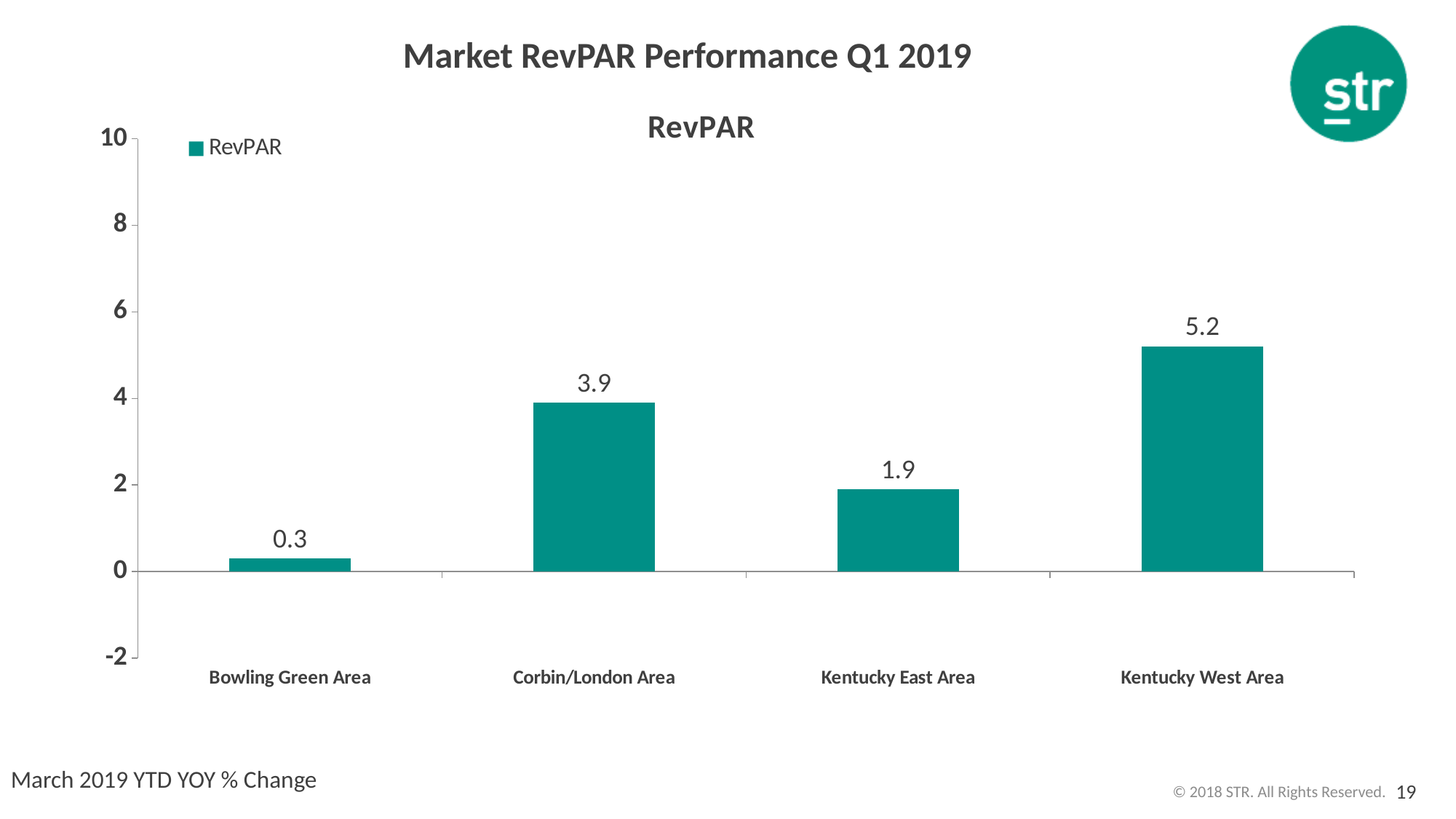
Which has a larger RevPAR value, Corbin/London Area or Kentucky East Area? Corbin/London Area What is the title of the slide? Market RevPAR Performance Q1 2019 Which area has the highest RevPAR value? Kentucky West Area What is the RevPAR value for Corbin/London Area? 3.9 How many areas are shown on the chart? 4 What is the RevPAR value for Bowling Green Area? 0.3 Is the RevPAR value for Kentucky West Area greater or less than 4? greater What kind of chart is shown on the slide? bar chart What is the difference between the RevPAR values for Kentucky West Area and Corbin/London Area? 1.3 What is the RevPAR value for Kentucky West Area? 5.2 What is the RevPAR value for Kentucky East Area? 1.9 Which area has the lowest RevPAR value? Bowling Green Area